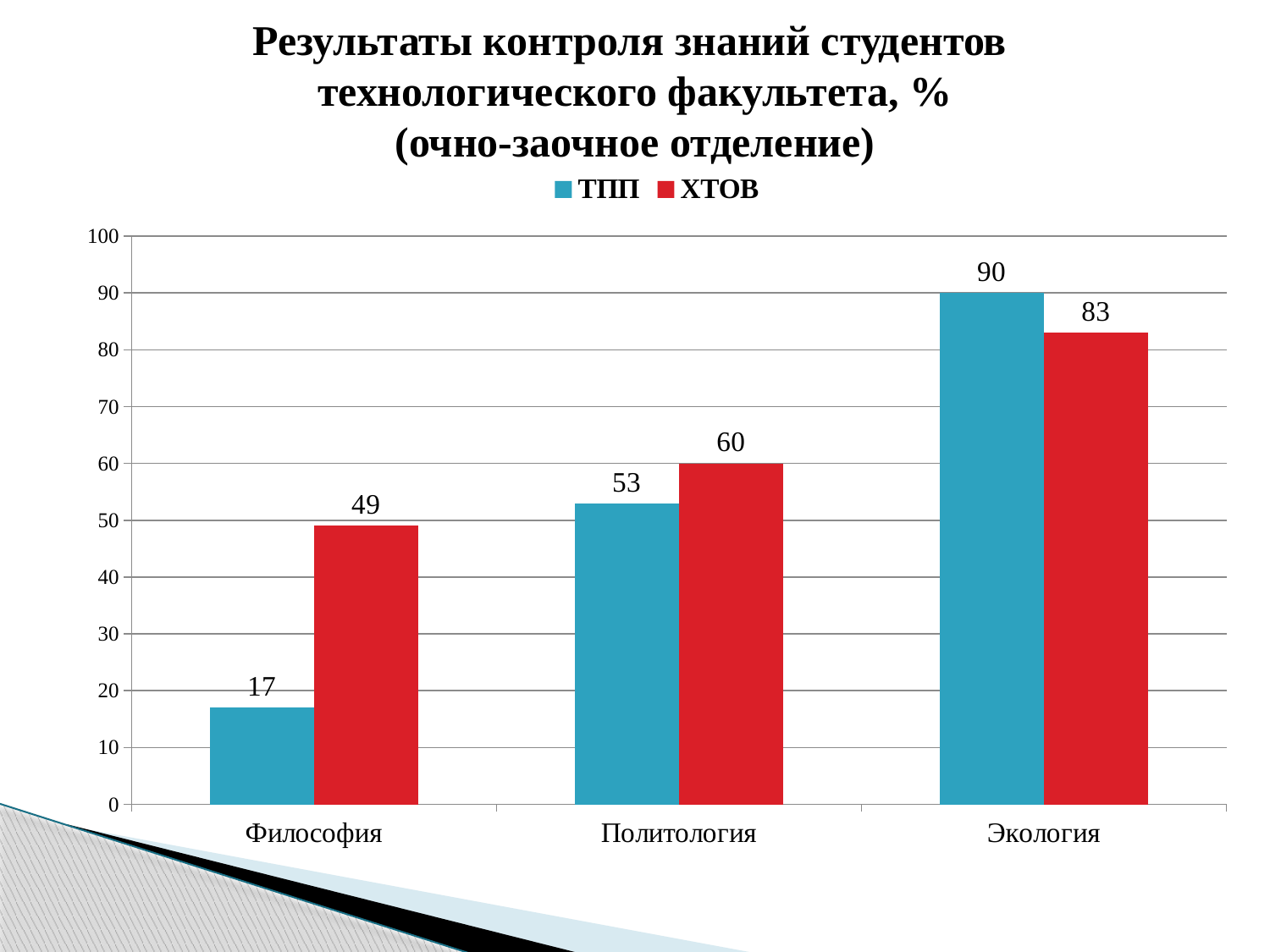
What is the value for ХТОВ in Экология? 83 What is the value for ХТОВ in Политология? 60 Which category has the lowest value for ХТОВ? Философия What is the difference between ХТОВ and ТПП in Философия? 32 What is the difference between ТПП and ХТОВ in Экология? 7 Which is larger in Политология, ТПП or ХТОВ? ХТОВ How many categories are shown on the x axis? 3 How many series does the legend list? 2 What is the value for ТПП in Философия? 17 Which category has the highest value for ТПП? Экология What kind of chart is this? bar chart Do the ТПП values rise or fall from Философия to Экология? rise